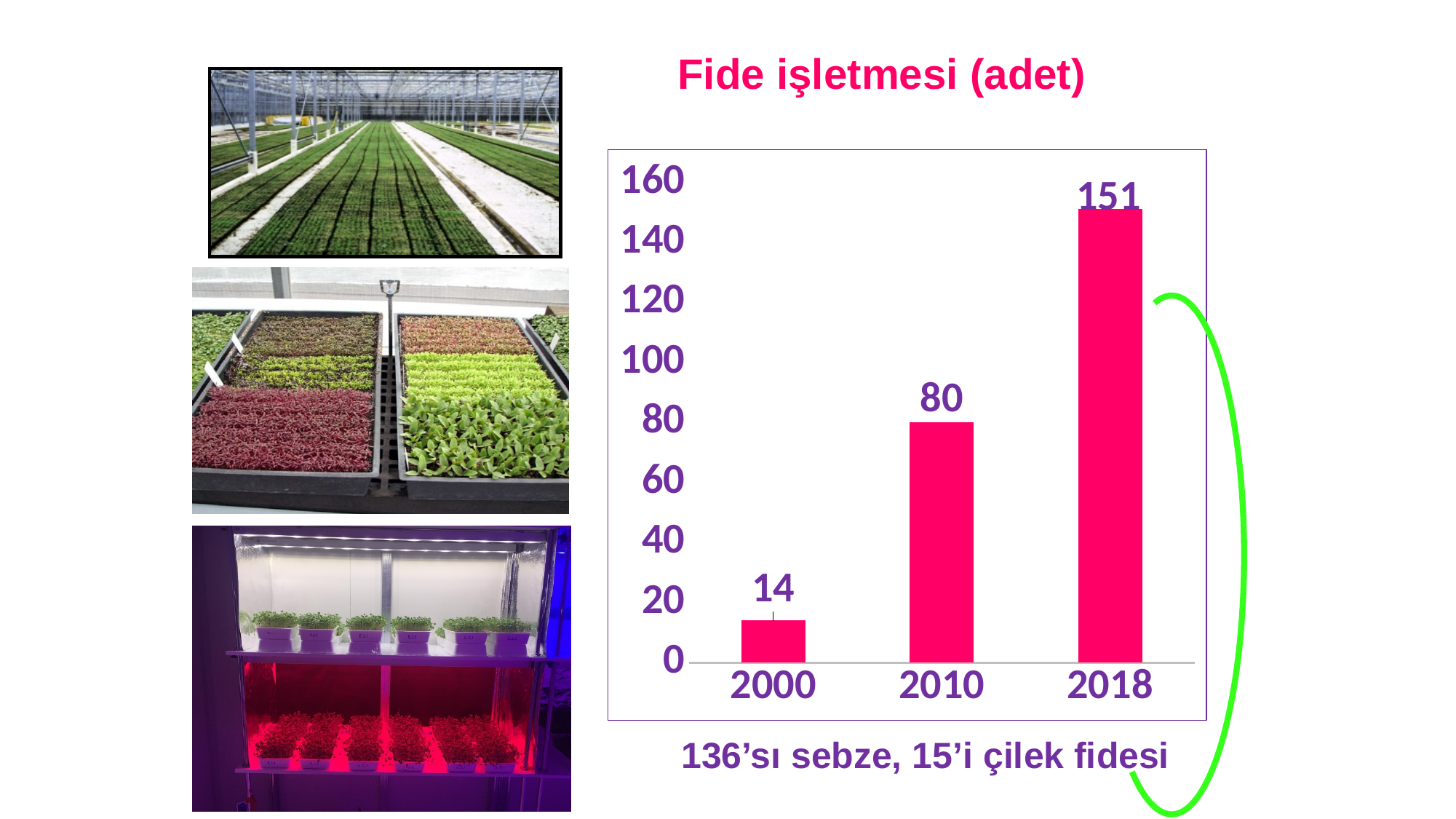
What is the difference between the values for 2018 and 2010? 71 Which year has the lowest value? 2000 Which is larger, the value for 2010 or the value for 2000? 2010 Is the value for 2018 greater or less than 140? greater What kind of chart is shown? bar chart What is the value for 2010? 80 Which year has the highest value? 2018 What is the value for 2018? 151 How many years are shown on the x axis? 3 What is the difference between the values for 2010 and 2000? 66 Do the values rise or fall from 2000 to 2018? rise What is the value for 2000? 14